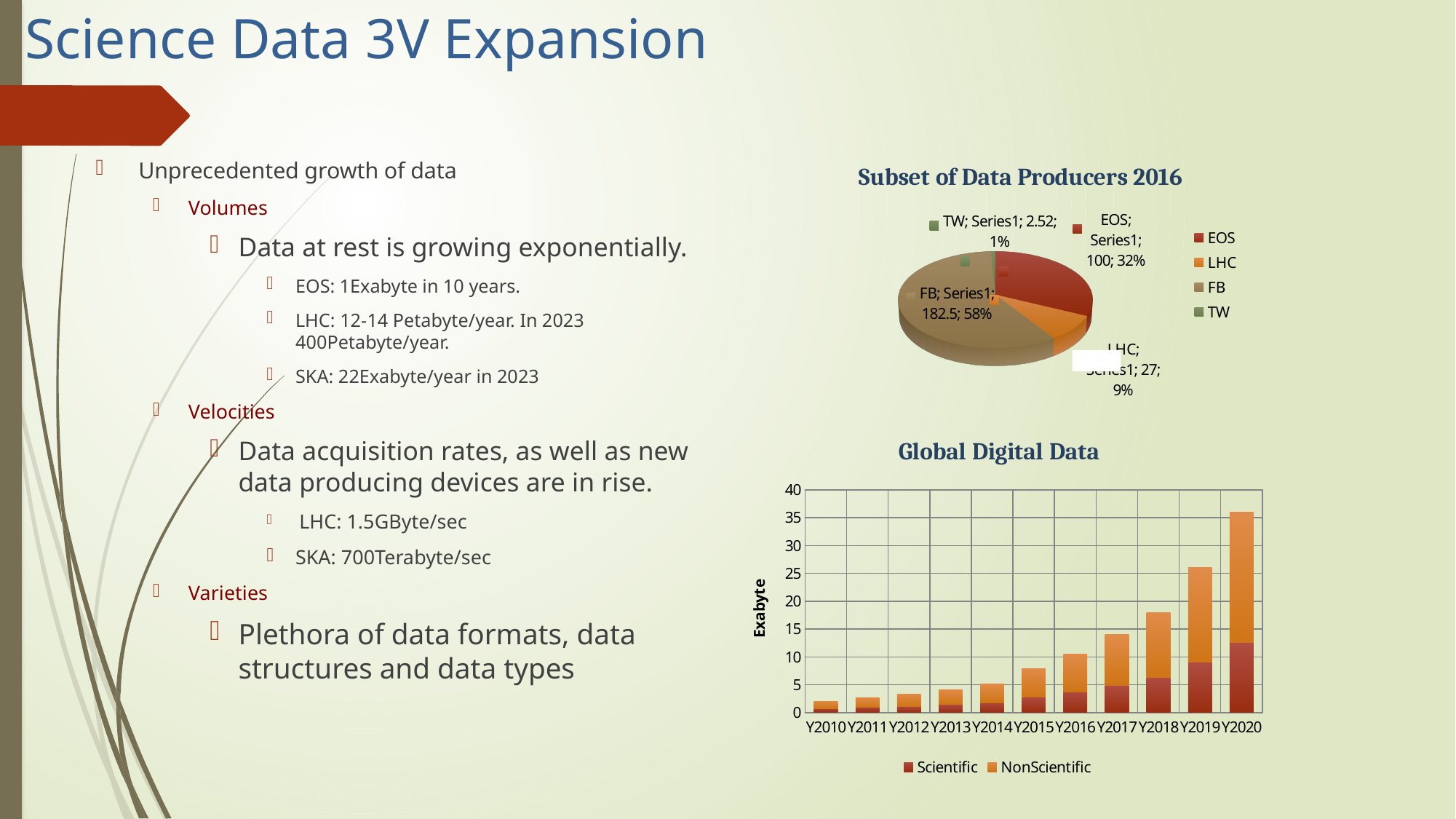
In the 'Subset of Data Producers 2016' chart, what percentage share does EOS have? 32% How many years are shown on the x axis of the 'Global Digital Data' chart? 11 How many slices does the 'Subset of Data Producers 2016' pie chart have? 4 In the 'Subset of Data Producers 2016' chart, what value is shown for LHC? 27 In the 'Global Digital Data' chart, is the total for Y2020 greater or less than 30? greater In the 'Subset of Data Producers 2016' chart, which producer has the smallest slice? TW In the 'Global Digital Data' chart, do the total bar heights rise or fall from Y2010 to Y2020? rise How many series does the legend of the 'Global Digital Data' chart list? 2 In the 'Subset of Data Producers 2016' chart, what value is shown for FB? 182.5 In the 'Subset of Data Producers 2016' chart, which producer has the largest slice? FB In the 'Subset of Data Producers 2016' chart, what is the difference between the values for FB and EOS? 82.5 What kind of chart is 'Global Digital Data'? Stacked bar chart